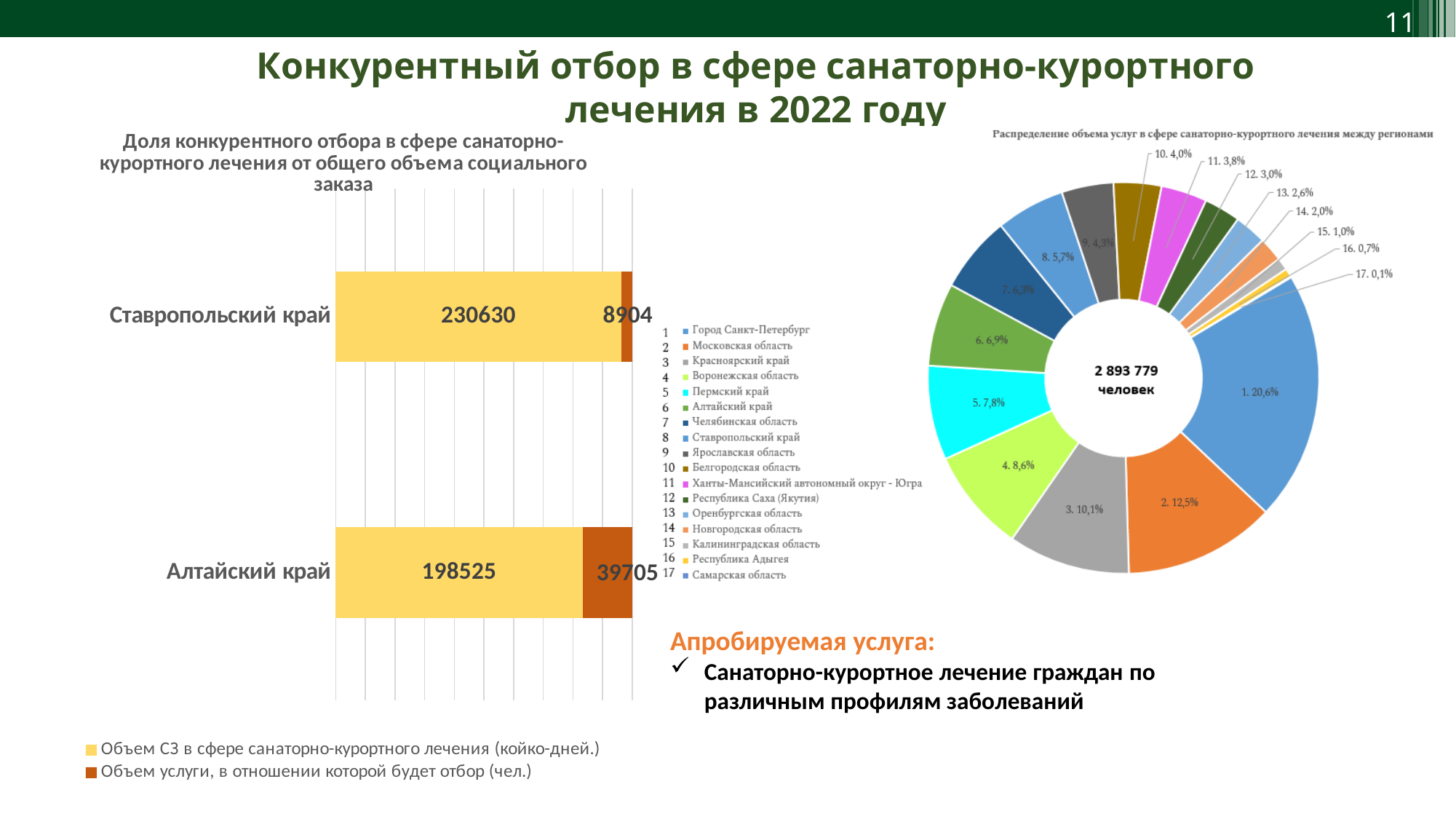
In the bar chart on the left, what is the total of the stacked bar for Алтайский край? 238230 In the donut chart 'Распределение объема услуг в сфере санаторно-курортного лечения между регионами', what share does Город Санкт-Петербург (segment 1) have? 20,6% In the bar chart on the left, what is the value of 'Объем СЗ в сфере санаторно-курортного лечения (койко-дней.)' for Ставропольский край? 230630 In the bar chart on the left, how many series does the legend list? 2 In the bar chart on the left, which region has the larger value of 'Объем услуги, в отношении которой будет отбор (чел.)', Ставропольский край or Алтайский край? Алтайский край What total number of people is shown in the centre of the donut chart on the right? 2 893 779 человек In the donut chart on the right, which region has the smallest share? Самарская область In the bar chart on the left, what is the difference between the 'Объем СЗ' values for Ставропольский край and Алтайский край? 32105 In the donut chart on the right, how many regions are listed in the legend? 17 In the bar chart on the left, what is the value of 'Объем услуги, в отношении которой будет отбор (чел.)' for Алтайский край? 39705 What type of chart is the chart on the left of the slide? Bar chart In the bar chart on the left, what is the value of 'Объем услуги, в отношении которой будет отбор (чел.)' for Ставропольский край? 8904